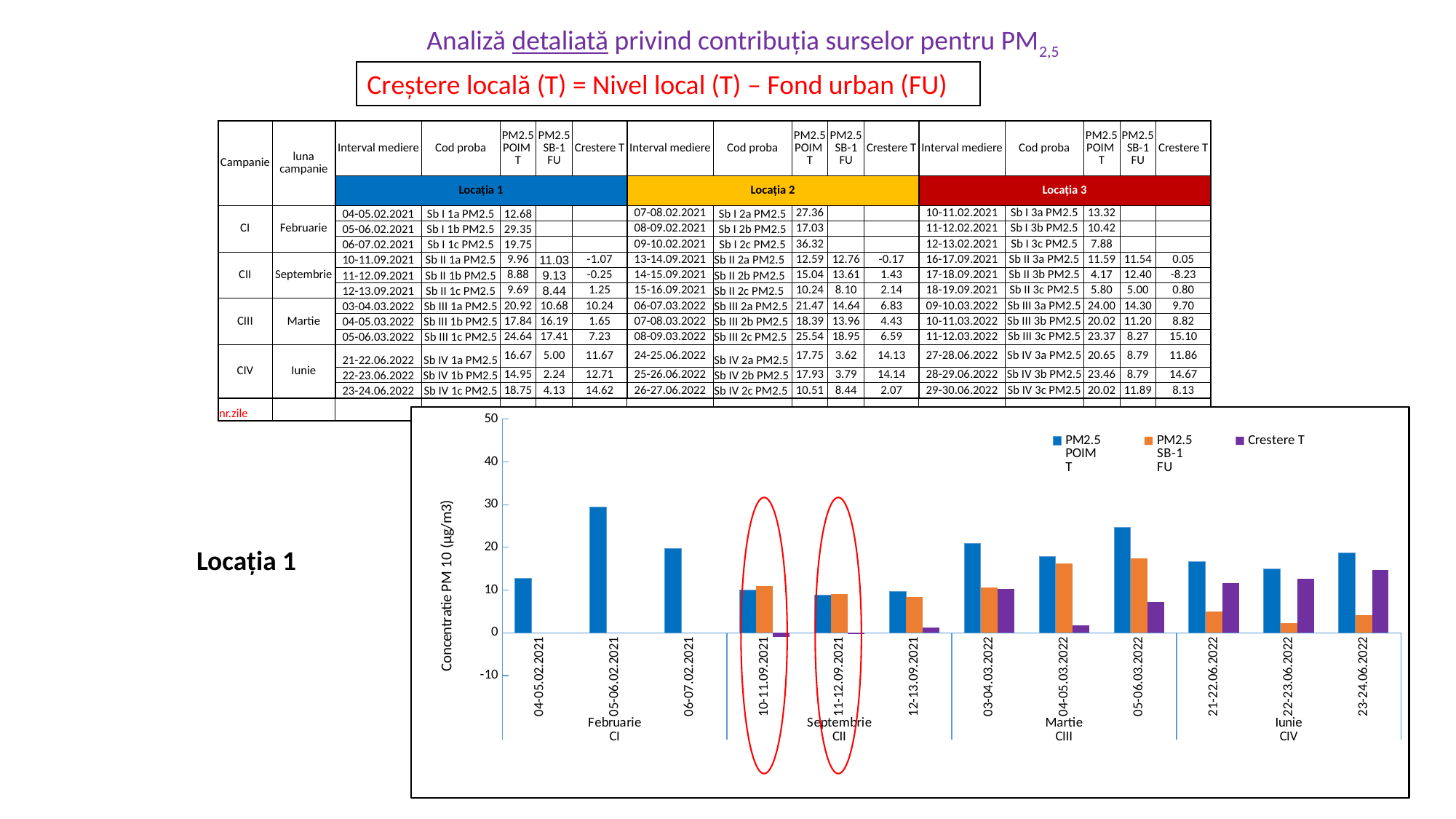
Which date has the highest PM2.5 POIM T bar in the chart? 05-06.02.2021 What kind of chart is shown on the slide? bar chart For 03-04.03.2022, which is larger: PM2.5 POIM T or PM2.5 SB-1 FU? PM2.5 POIM T How many series does the chart legend list? 3 How many date categories are plotted along the x axis of the chart? 12 Which date has the highest PM2.5 SB-1 FU bar in the chart? 05-06.03.2022 According to the table for Locația 1, what is the PM2.5 POIM T value for 04-05.02.2021? 12.68 Do the Crestere T values rise or fall across the three Iunie CIV dates (21-22.06.2022 to 23-24.06.2022)? rise Is the PM2.5 SB-1 FU value for 22-23.06.2022 greater or less than 10? less Is the PM2.5 POIM T value for 05-06.02.2021 greater or less than 20? greater What is the title of the chart's vertical axis? Concentratie PM 10 (µg/m3) Which date has the lowest Crestere T bar in the chart? 10-11.09.2021